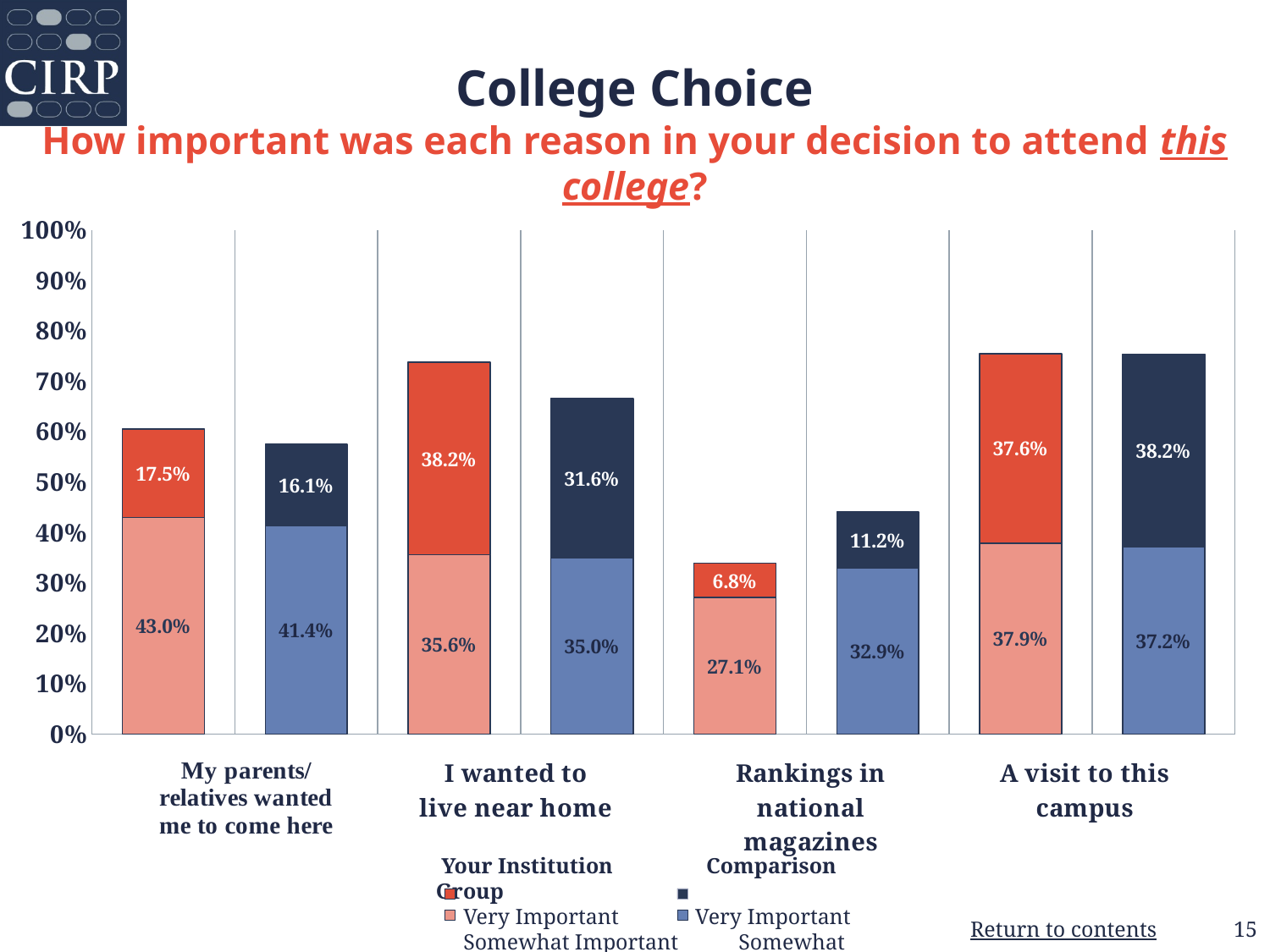
What is the difference between the Very Important percentages for Your Institution and the Comparison Group on 'I wanted to live near home'? 6.6% For 'Rankings in national magazines', which group has the larger Very Important percentage, Your Institution or the Comparison Group? Comparison Group Which reason has the lowest Very Important percentage for Your Institution? Rankings in national magazines Is the total stacked bar for Your Institution on 'My parents/relatives wanted me to come here' greater or less than 50%? greater How many entries does the legend list? 4 What percentage of Your Institution students rated 'My parents/relatives wanted me to come here' as Somewhat Important? 43.0% How many reasons (categories) are shown along the x axis? 4 What is the total percentage (Very Important plus Somewhat Important) for the Comparison Group on 'Rankings in national magazines'? 44.1% What is the total percentage (Very Important plus Somewhat Important) for Your Institution on 'I wanted to live near home'? 73.8% What kind of chart is shown on the slide? stacked bar chart What percentage of the Comparison Group rated 'Rankings in national magazines' as Somewhat Important? 32.9% What percentage of Your Institution students rated 'A visit to this campus' as Very Important? 37.6%